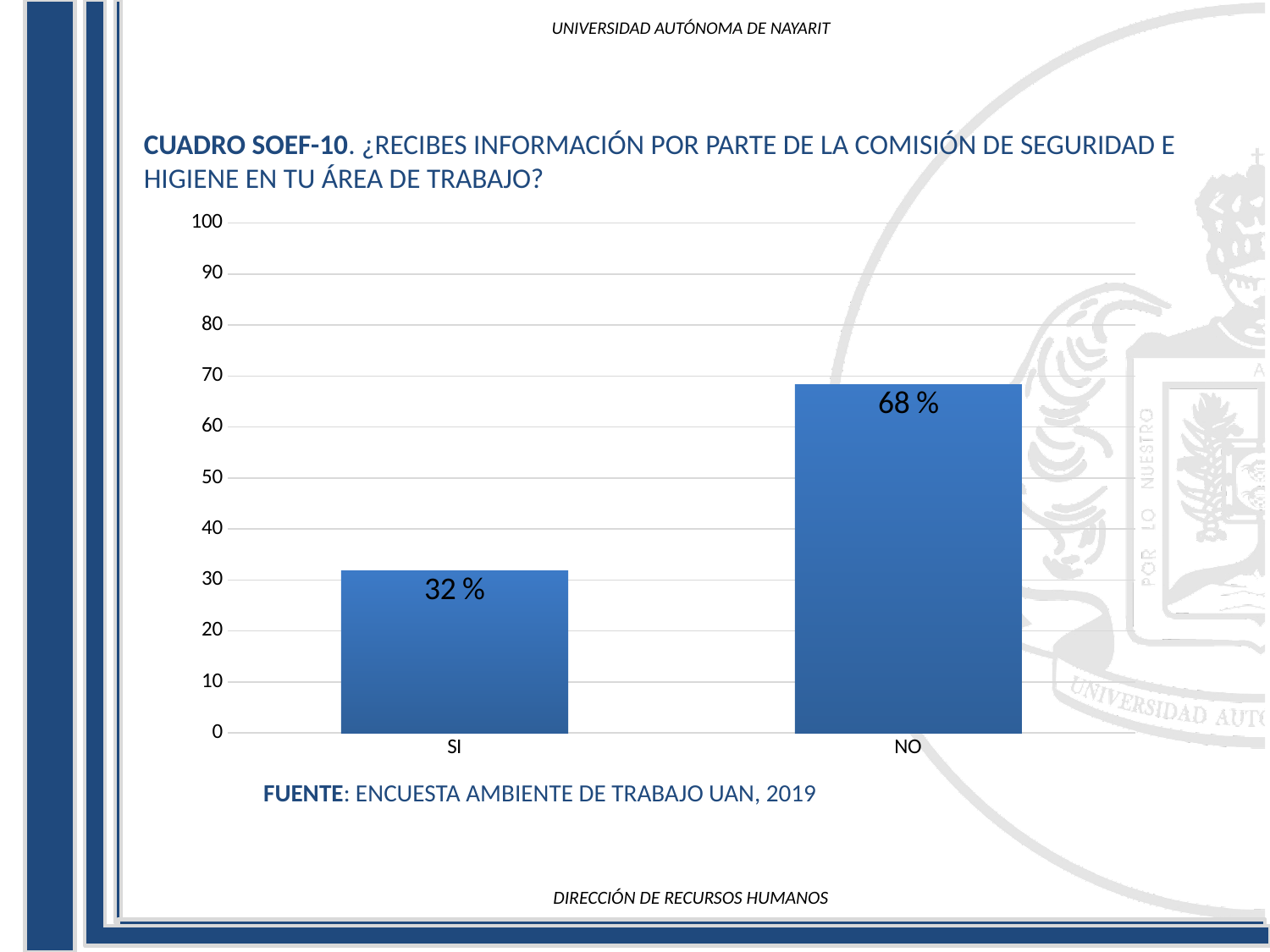
What is the value for NO? 68 % Which is larger, the value for SI or the value for NO? NO What source is cited below the chart? ENCUESTA AMBIENTE DE TRABAJO UAN, 2019 Which category has the highest value? NO Which category has the lowest value? SI Is the value for SI greater or less than 40? less What is the difference between the values for NO and SI? 36 % What kind of chart is shown on the slide? bar chart Is the value for NO greater or less than 60? greater How many categories are shown on the x axis? 2 What is the value for SI? 32 % What is the maximum value shown on the y axis? 100